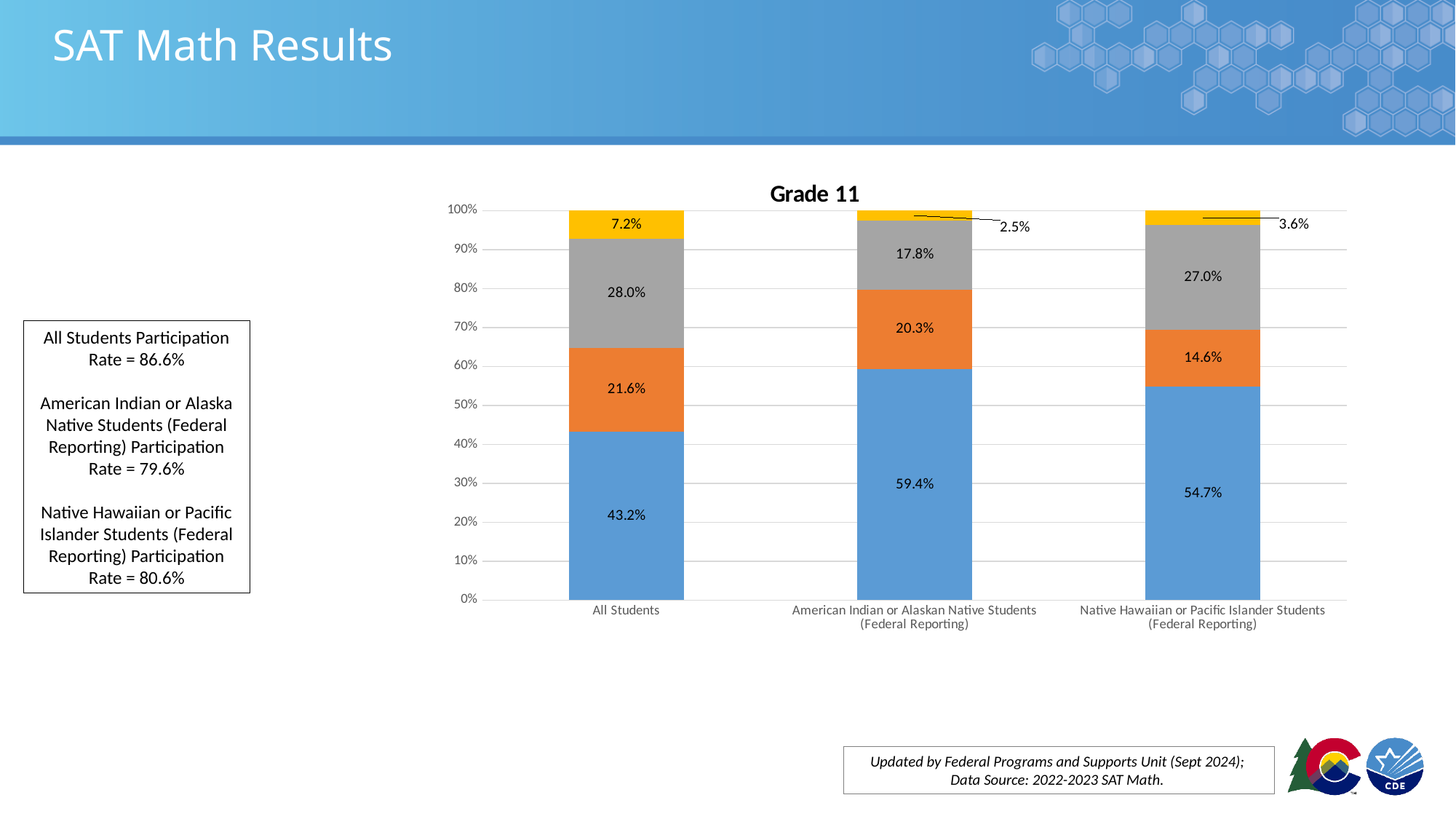
What type of chart is shown on the slide? stacked bar chart Which category has the largest blue (bottom) segment? American Indian or Alaskan Native Students (Federal Reporting) What is the value of the blue (bottom) segment for American Indian or Alaskan Native Students (Federal Reporting)? 59.4% Which category has the smallest yellow (top) segment? American Indian or Alaskan Native Students (Federal Reporting) What is the value of the orange segment for Native Hawaiian or Pacific Islander Students (Federal Reporting)? 14.6% Is the orange segment larger for All Students or for Native Hawaiian or Pacific Islander Students (Federal Reporting)? All Students What is the value of the yellow (top) segment for Native Hawaiian or Pacific Islander Students (Federal Reporting)? 3.6% How many categories are shown on the x axis of the chart? 3 What is the title of the chart? Grade 11 What is the value of the blue (bottom) segment for All Students? 43.2% What is the difference between the blue segment values for American Indian or Alaskan Native Students and All Students? 16.2% What is the value of the gray segment for All Students? 28.0%